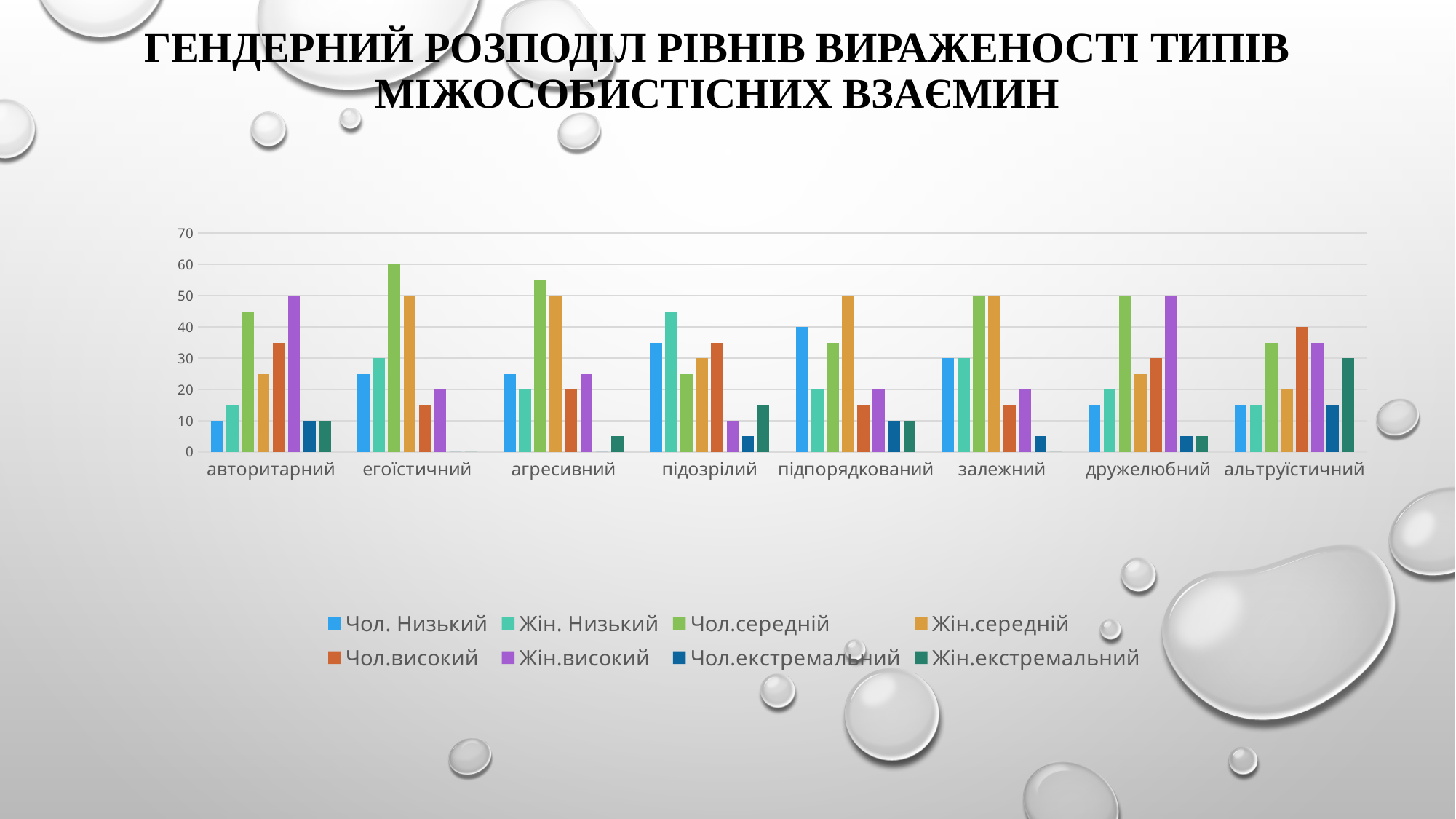
How many series does the legend list? 8 What is the value of Чол.середній for егоїстичний? 60 What type of chart is shown on the slide? bar chart What is the difference between Чол.середній and Жін.середній for егоїстичний? 10 How many categories are shown along the x axis? 8 What is the value of Чол. Низький for підпорядкований? 40 Which series has the highest bar in the авторитарний category? Жін.високий Which series has the lowest bar in the підозрілий category? Чол.екстремальний What is the value of Жін.високий for авторитарний? 50 For егоїстичний, which is larger: Чол.середній or Жін.середній? Чол.середній Is the value of Чол.середній for агресивний greater or less than 50? greater Is the value of Чол.високий for авторитарний greater or less than 40? less